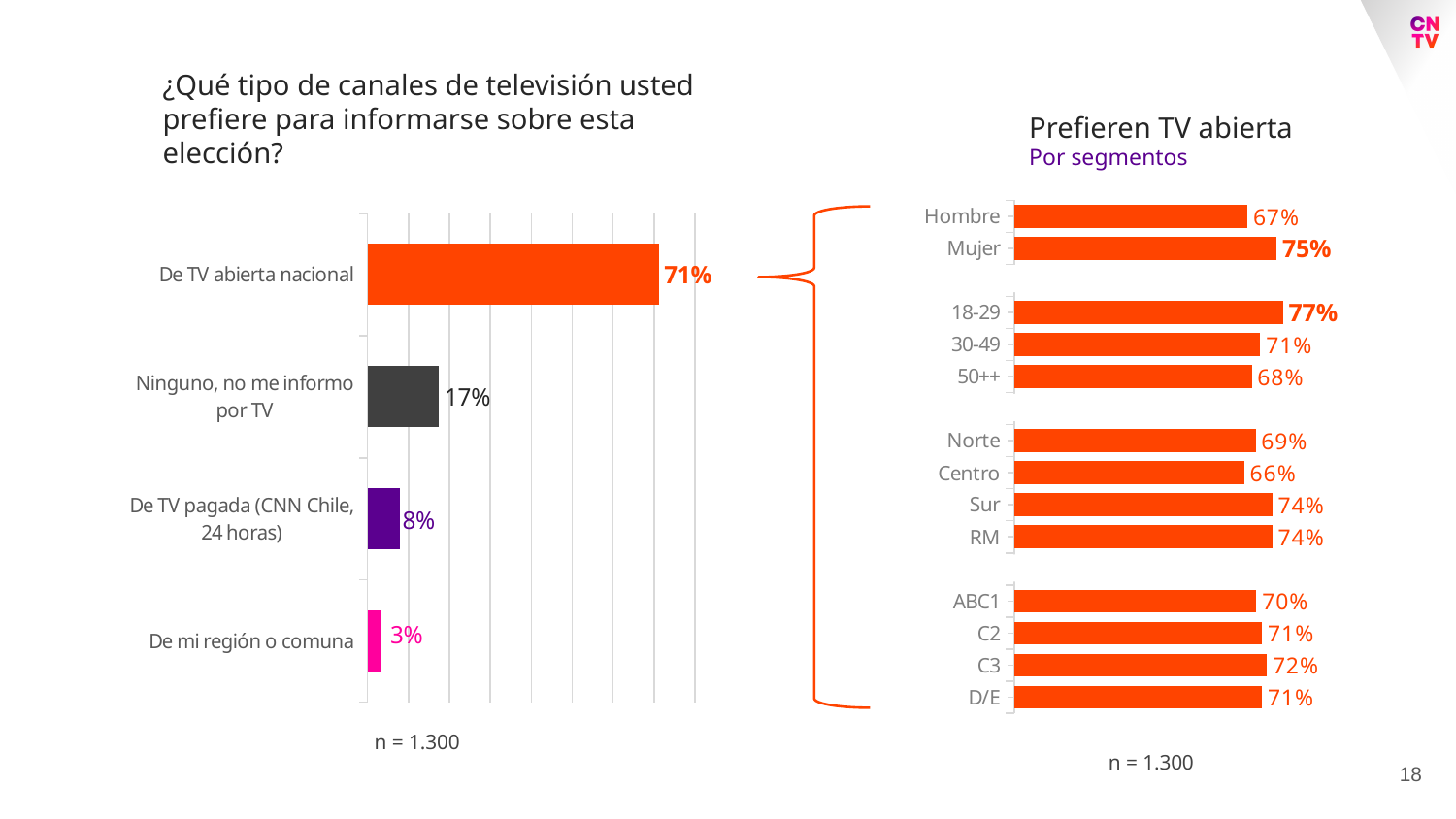
In the left chart, what is the value for 'Ninguno, no me informo por TV'? 17% How many segments are shown in the 'Prefieren TV abierta' chart? 13 In the 'Prefieren TV abierta' chart, what is the difference between Mujer and Hombre? 8% In the left chart, what is the difference between 'De TV abierta nacional' and 'De TV pagada (CNN Chile, 24 horas)'? 63% In the 'Prefieren TV abierta' chart, which segment has the lowest value? Centro What kind of chart is the left chart? Bar chart In the left chart, which category has the lowest value? De mi región o comuna How many categories are shown in the left chart? 4 In the left chart, what percentage of respondents prefer 'De TV abierta nacional'? 71% In the 'Prefieren TV abierta' chart, what is the value for Mujer? 75% In the 'Prefieren TV abierta' chart, which segment has the highest value? 18-29 In the 'Prefieren TV abierta' chart, which is larger, Sur or Centro? Sur